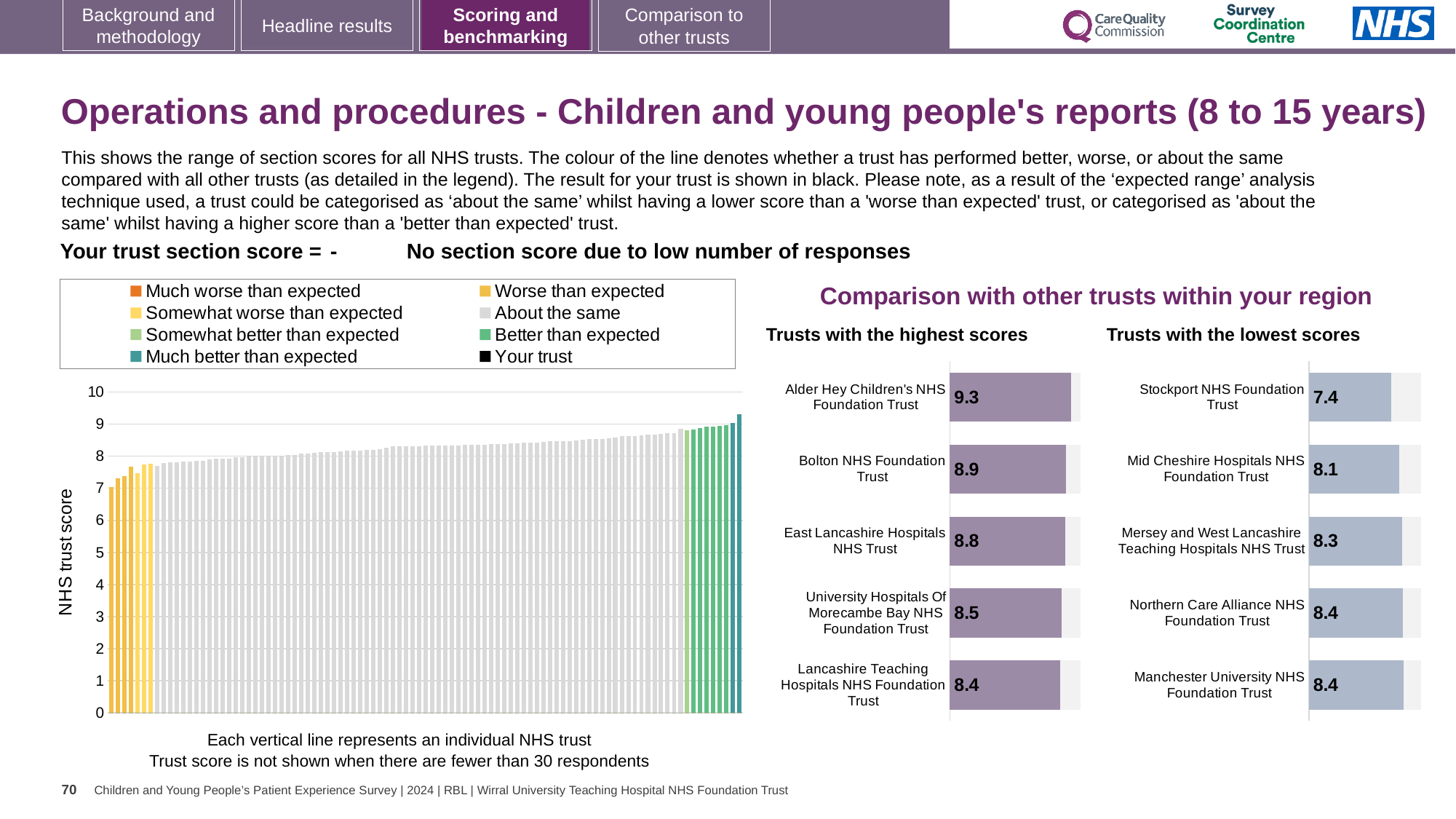
In the 'Trusts with the lowest scores' chart, what is the score for Stockport NHS Foundation Trust? 7.4 In the 'Trusts with the highest scores' chart, what is the score for Alder Hey Children's NHS Foundation Trust? 9.3 How many trusts are listed in the 'Trusts with the highest scores' chart? 5 In the 'Trusts with the highest scores' chart, which trust has the lowest score shown? Lancashire Teaching Hospitals NHS Foundation Trust In the main 'NHS trust score' chart on the left, is the value of the leftmost (lowest) bar greater or less than 8? less What kind of chart is the main 'NHS trust score' chart on the left? bar chart In the 'Trusts with the lowest scores' chart, which trust has the lowest score? Stockport NHS Foundation Trust How many entries does the legend above the main 'NHS trust score' chart list? 8 In the 'Trusts with the highest scores' chart, what is the difference between the scores of Alder Hey Children's NHS Foundation Trust and Bolton NHS Foundation Trust? 0.4 In the main 'NHS trust score' chart on the left, do the bar values rise or fall from left to right? rise In the 'Trusts with the lowest scores' chart, which has the higher score: Stockport NHS Foundation Trust or Mersey and West Lancashire Teaching Hospitals NHS Trust? Mersey and West Lancashire Teaching Hospitals NHS Trust In the 'Trusts with the lowest scores' chart, what is the difference between the scores of Mid Cheshire Hospitals NHS Foundation Trust and Stockport NHS Foundation Trust? 0.7